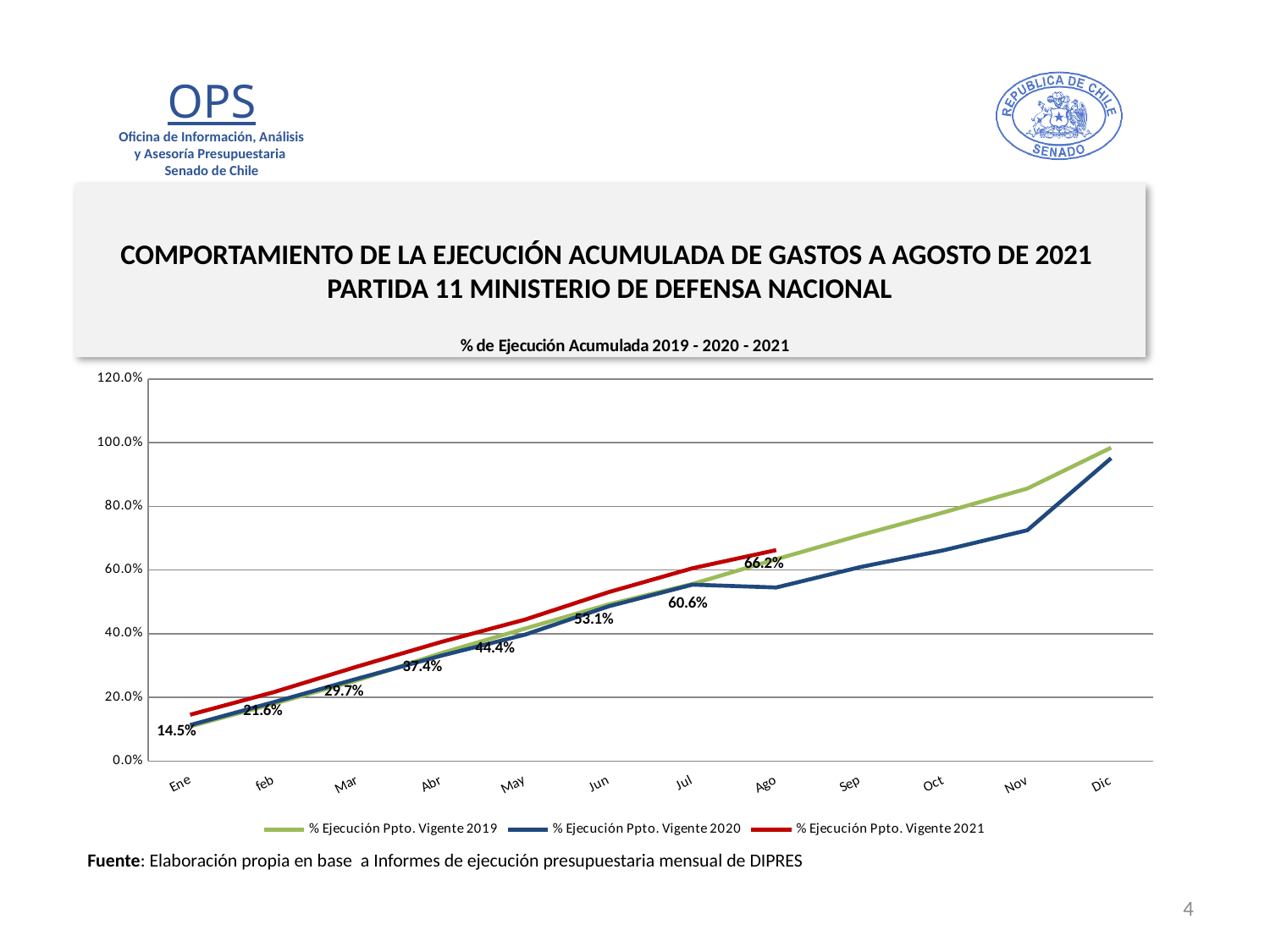
Is the value for % Ejecución Ppto. Vigente 2019 in Dic greater or less than 80.0%? greater What kind of chart is shown on the slide? line chart Is the value for % Ejecución Ppto. Vigente 2020 in Ago greater or less than 60.0%? less What is the difference between the 2021 values for Ago and Jul? 5.6 percentage points How many months are shown along the x axis? 12 What is the value for % Ejecución Ppto. Vigente 2021 in Ene? 14.5% Does the % Ejecución Ppto. Vigente 2021 line rise or fall from Ene to Ago? rise What is the value for % Ejecución Ppto. Vigente 2021 in Ago? 66.2% How many series does the legend list? 3 What is the value for % Ejecución Ppto. Vigente 2021 in Abr? 37.4% What is the title of the chart? % de Ejecución Acumulada 2019 - 2020 - 2021 In Ago, which series is higher: % Ejecución Ppto. Vigente 2021 or % Ejecución Ppto. Vigente 2020? % Ejecución Ppto. Vigente 2021